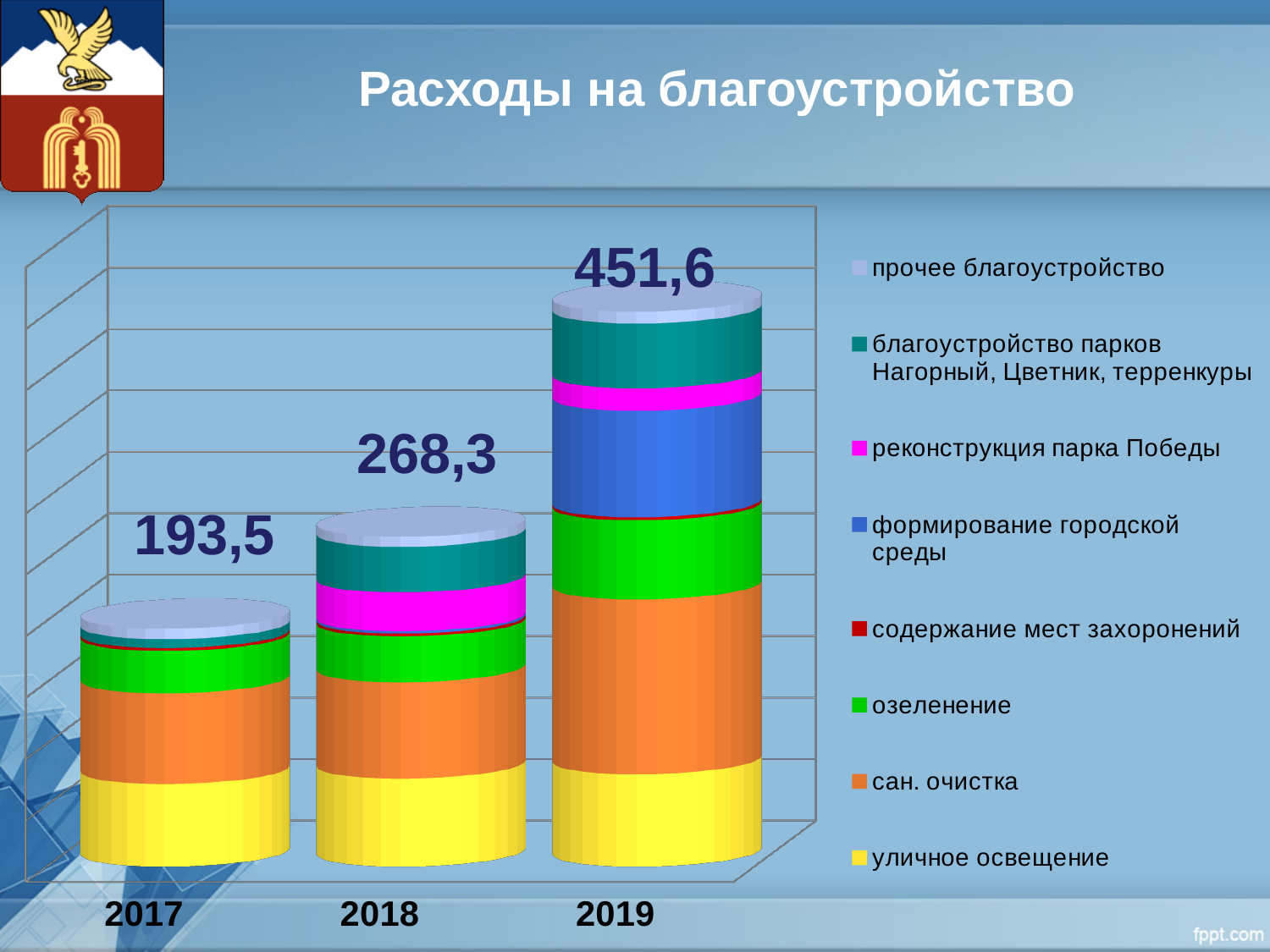
Which is larger, the total for 2018 or the total for 2017? 2018 How many series does the legend list? 8 Which year has the highest total expenditure? 2019 What is the total value shown for 2019? 451,6 What is the difference between the totals for 2019 and 2018? 183,3 What is the total value shown for 2017? 193,5 What is the total value shown for 2018? 268,3 What kind of chart is shown on the slide? stacked bar chart What is the difference between the totals for 2018 and 2017? 74,8 How many years are shown on the x axis? 3 Do the total values rise or fall from 2017 to 2019? rise Which year has the lowest total expenditure? 2017